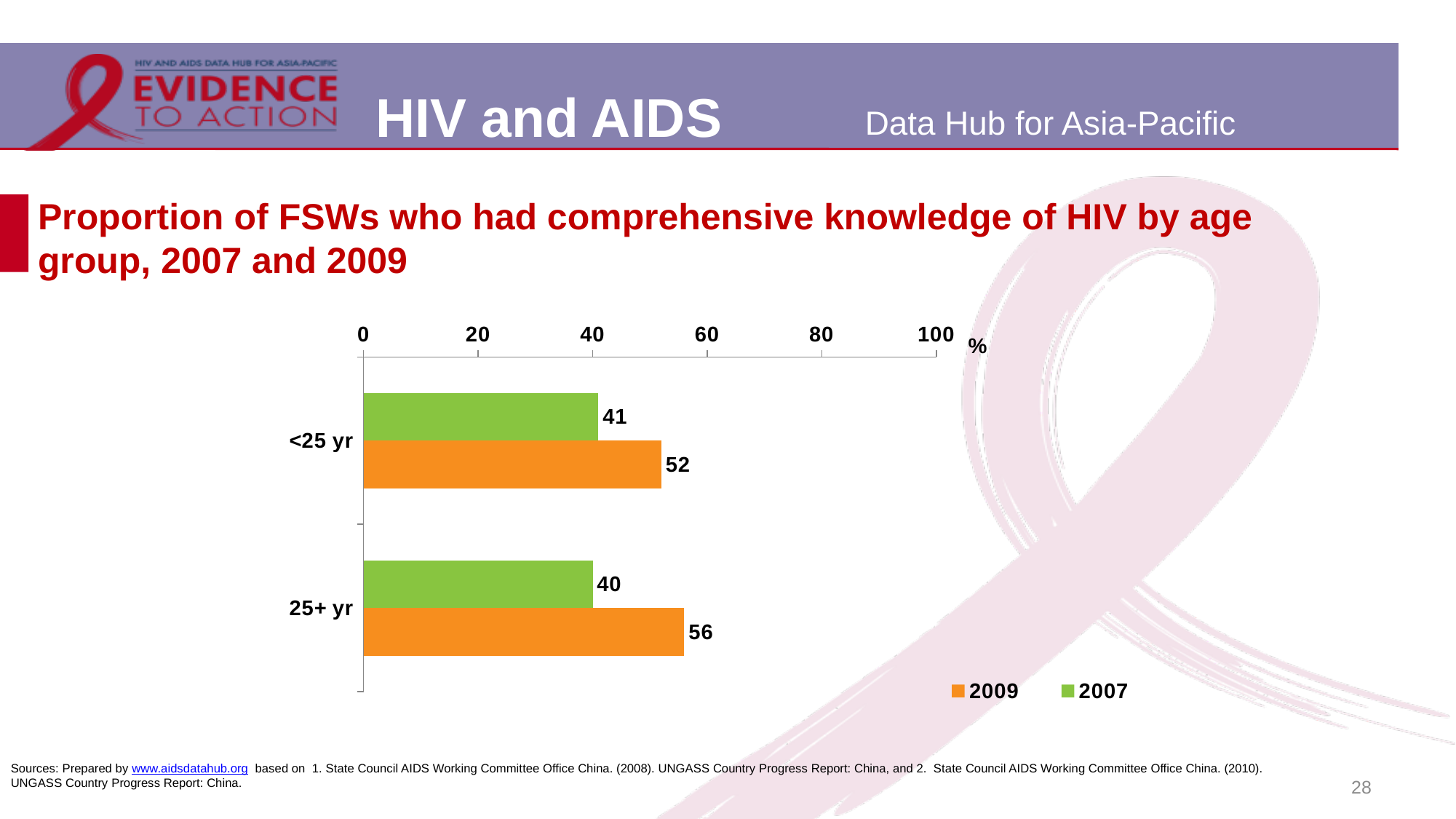
Which age group has the highest value in 2009? 25+ yr How many age groups are shown in the chart? 2 What is the value for the 25+ yr age group in 2009? 56 What is the difference between the 2009 and 2007 values for the <25 yr age group? 11 What is the value for the <25 yr age group in 2009? 52 What kind of chart is shown on the slide? bar chart Is the value for the 25+ yr age group in 2009 greater or less than 40? greater What is the difference between the 2009 and 2007 values for the 25+ yr age group? 16 What is the value for the <25 yr age group in 2007? 41 What is the value for the 25+ yr age group in 2007? 40 Which is larger for the <25 yr age group, the 2007 value or the 2009 value? 2009 How many series does the legend list? 2